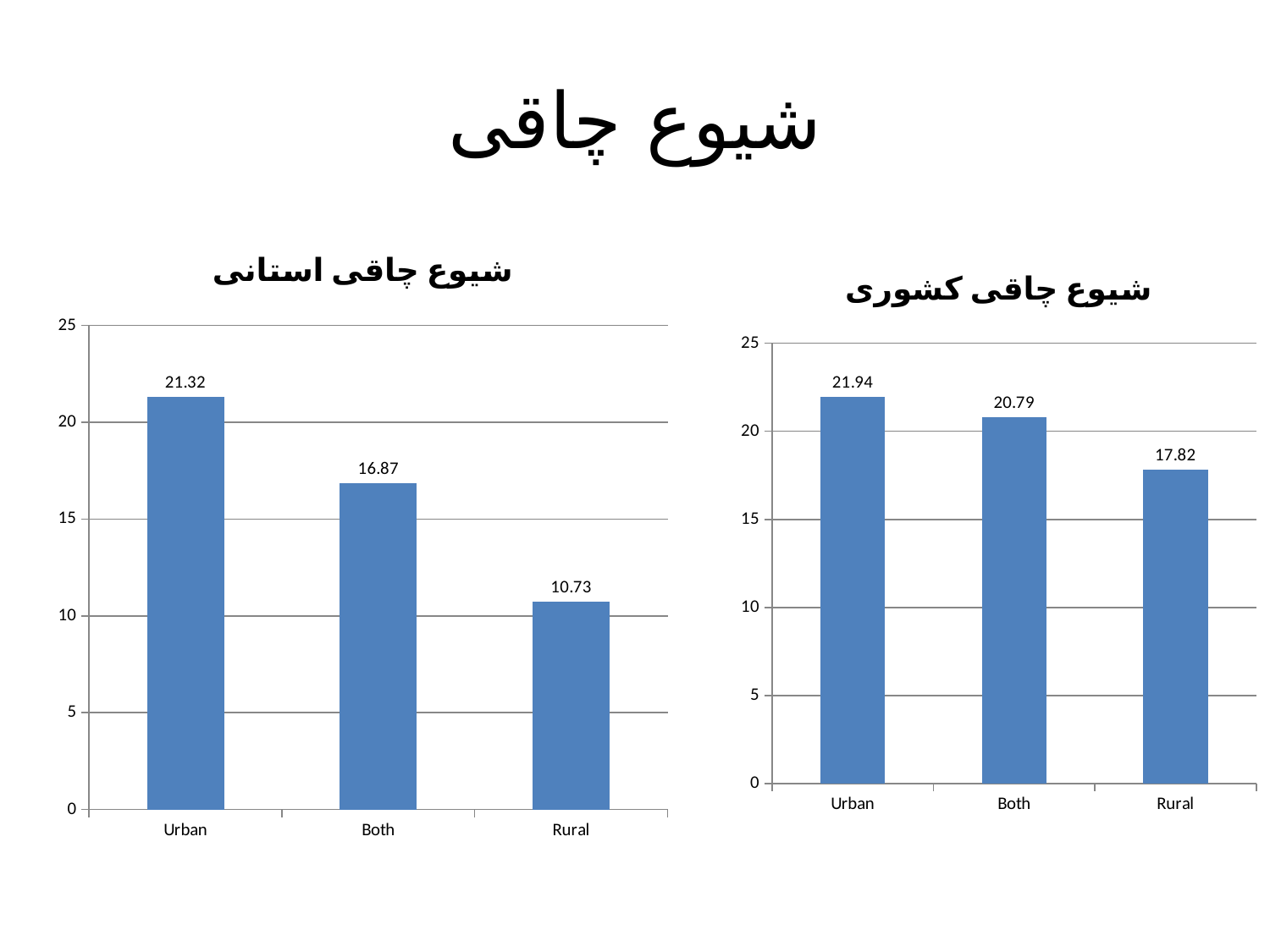
In the left chart (شیوع چاقی استانی), what is the value for Urban? 21.32 In the left chart (شیوع چاقی استانی), is the value for Both greater or less than 15? greater In the left chart (شیوع چاقی استانی), which category has the lowest value? Rural In the right chart (شیوع چاقی کشوری), what is the difference between the Urban and Both values? 1.15 In the right chart (شیوع چاقی کشوری), what is the value for Both? 20.79 How many categories are shown in the right chart (شیوع چاقی کشوری)? 3 Which is larger: the Rural value in the left chart or the Rural value in the right chart? The Rural value in the right chart (17.82) In the right chart (شیوع چاقی کشوری), do the values rise or fall from Urban to Rural? Fall In the right chart (شیوع چاقی کشوری), what is the value for Rural? 17.82 What kind of chart is the left chart (شیوع چاقی استانی)? Bar chart In the left chart (شیوع چاقی استانی), what is the difference between the Urban and Rural values? 10.59 In the right chart (شیوع چاقی کشوری), which category has the highest value? Urban